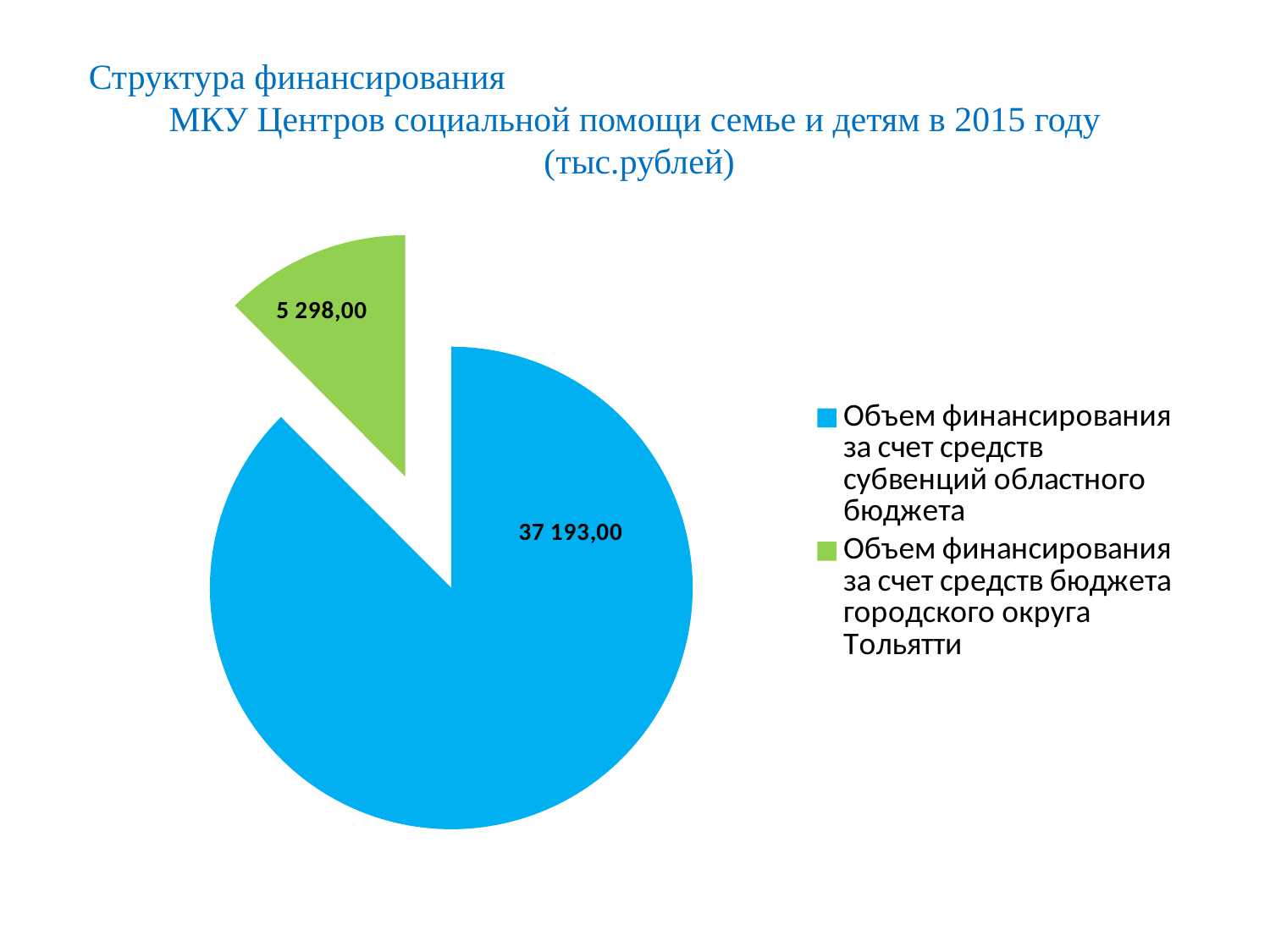
What colour is the slice for funding from the Tolyatti city budget? Green What kind of chart is shown on the slide? Pie chart What is the value for "Объем финансирования за счет средств бюджета городского округа Тольятти"? 5 298,00 What is the difference between the regional budget subventions value and the Tolyatti city budget value? 31 895,00 What is the total funding across both slices of the pie? 42 491,00 Which funding source has the largest slice of the pie? Объем финансирования за счет средств субвенций областного бюджета How many entries does the legend list? 2 Which funding source has the smallest slice of the pie? Объем финансирования за счет средств бюджета городского округа Тольятти What is the value for "Объем финансирования за счет средств субвенций областного бюджета"? 37 193,00 How many slices does the pie chart have? 2 Which is larger: funding from regional budget subventions or funding from the Tolyatti city budget? Объем финансирования за счет средств субвенций областного бюджета